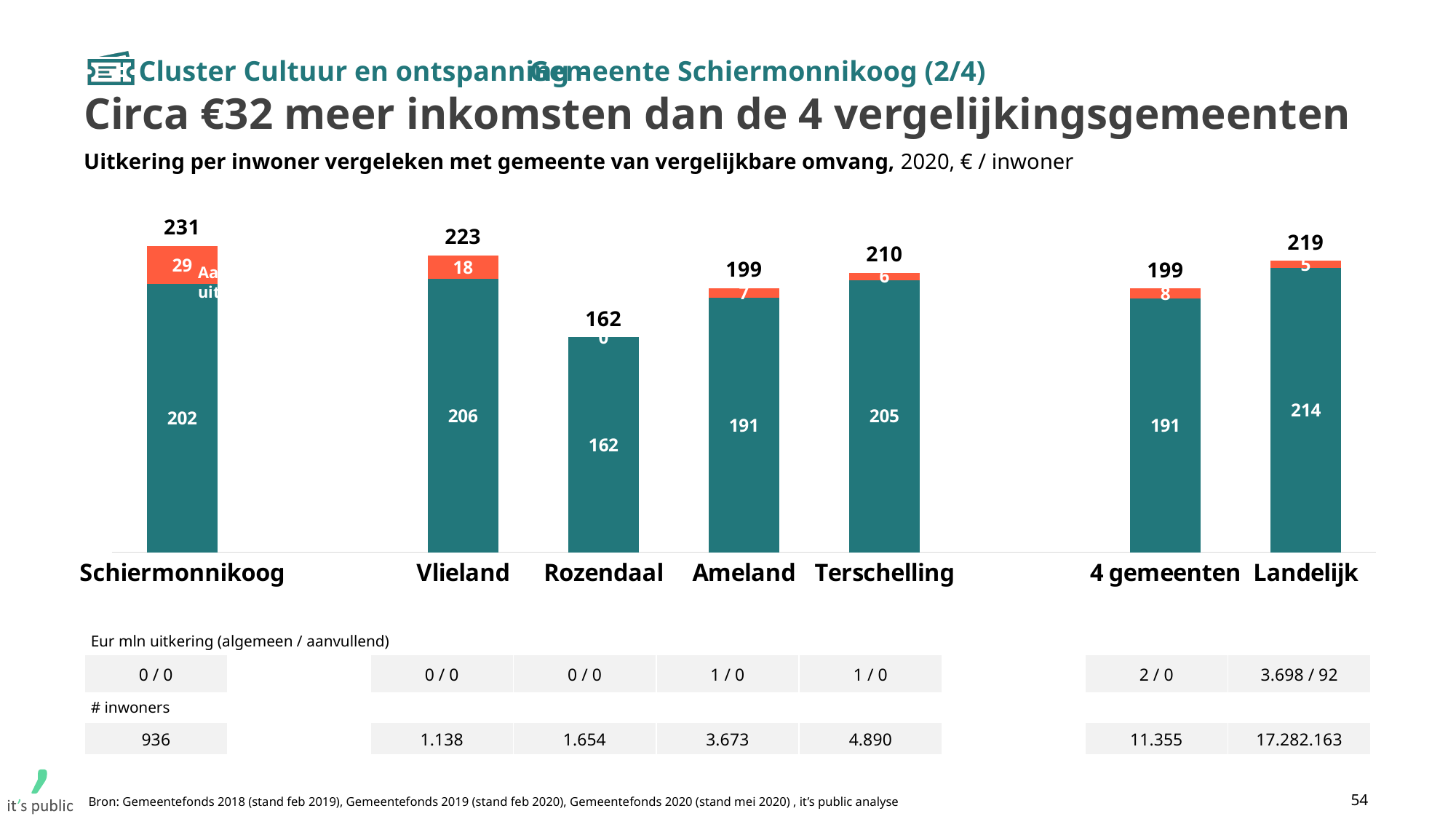
How many categories are shown on the x axis of the chart? 7 Which category has the lowest total value? Rozendaal Which category has the highest total value? Schiermonnikoog What is the total value shown above the bar for Schiermonnikoog? 231 What is the value of the orange (upper) segment for Schiermonnikoog? 29 Which has a larger total value, Vlieland or Terschelling? Vlieland What is the sum of the teal and orange segments for Ameland? 198 What is the value of the teal (lower) segment for Vlieland? 206 What kind of chart is shown on the slide? Stacked bar chart What is the total value shown above the bar for Landelijk? 219 What is the difference between the total for Schiermonnikoog and the total for 4 gemeenten? 32 What is the value of the orange (upper) segment for Rozendaal? 0